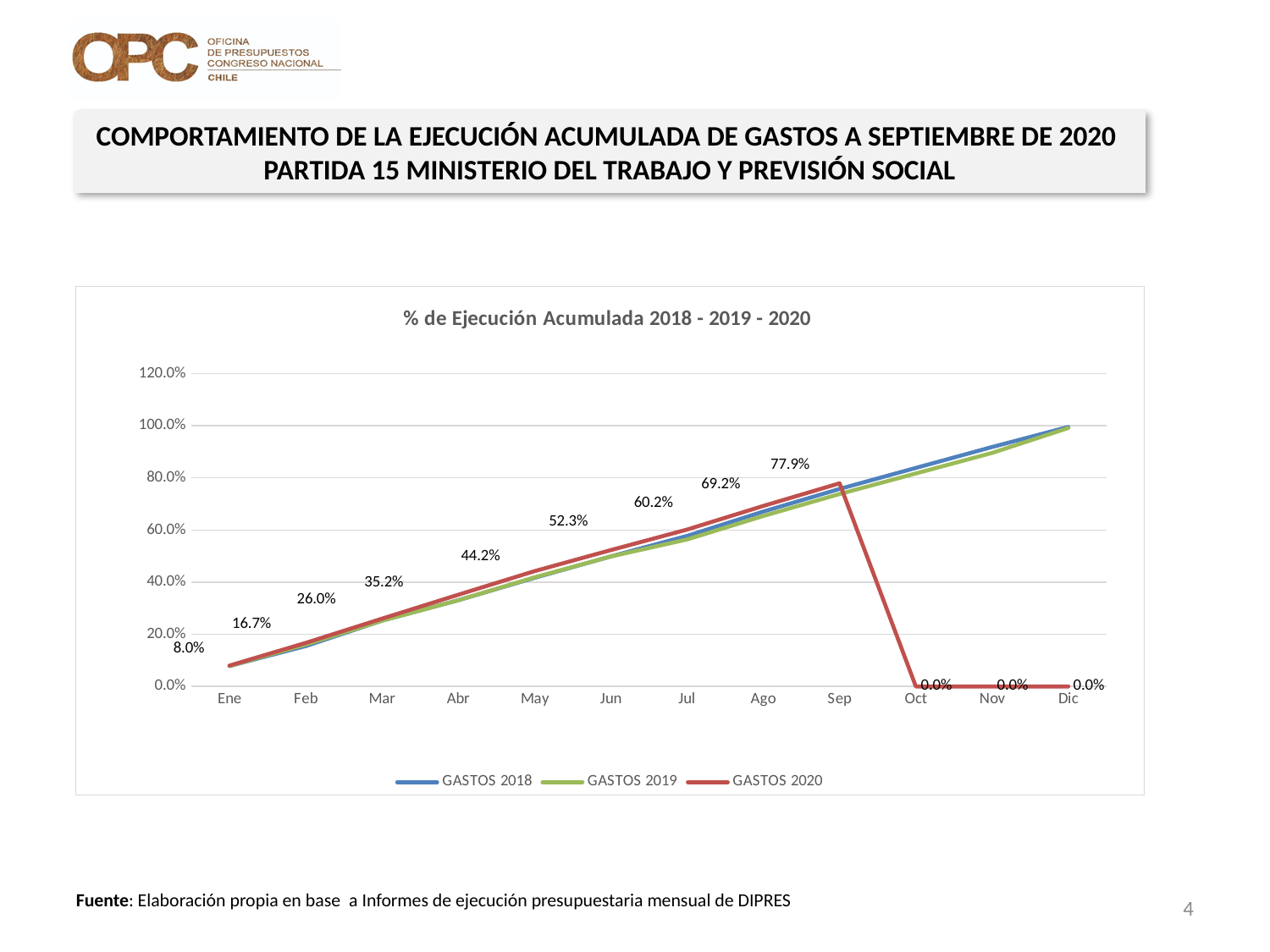
How many months are shown on the x axis? 12 What is the value for GASTOS 2020 in Sep? 77.9% What is the value for GASTOS 2020 in Ene? 8.0% What is the chart's title? % de Ejecución Acumulada 2018 - 2019 - 2020 Does the GASTOS 2020 line rise or fall from Ene to Sep? rise What is the difference between the GASTOS 2020 values for Sep and Ago? 8.7% What type of chart is shown on the slide? line chart How many series does the legend list? 3 Which is larger for GASTOS 2020: the value in Jun or the value in Mar? Jun Is the value for GASTOS 2018 in Dic greater or less than 80.0%? greater What is the value for GASTOS 2020 in May? 44.2% What is the value for GASTOS 2020 in Oct? 0.0%